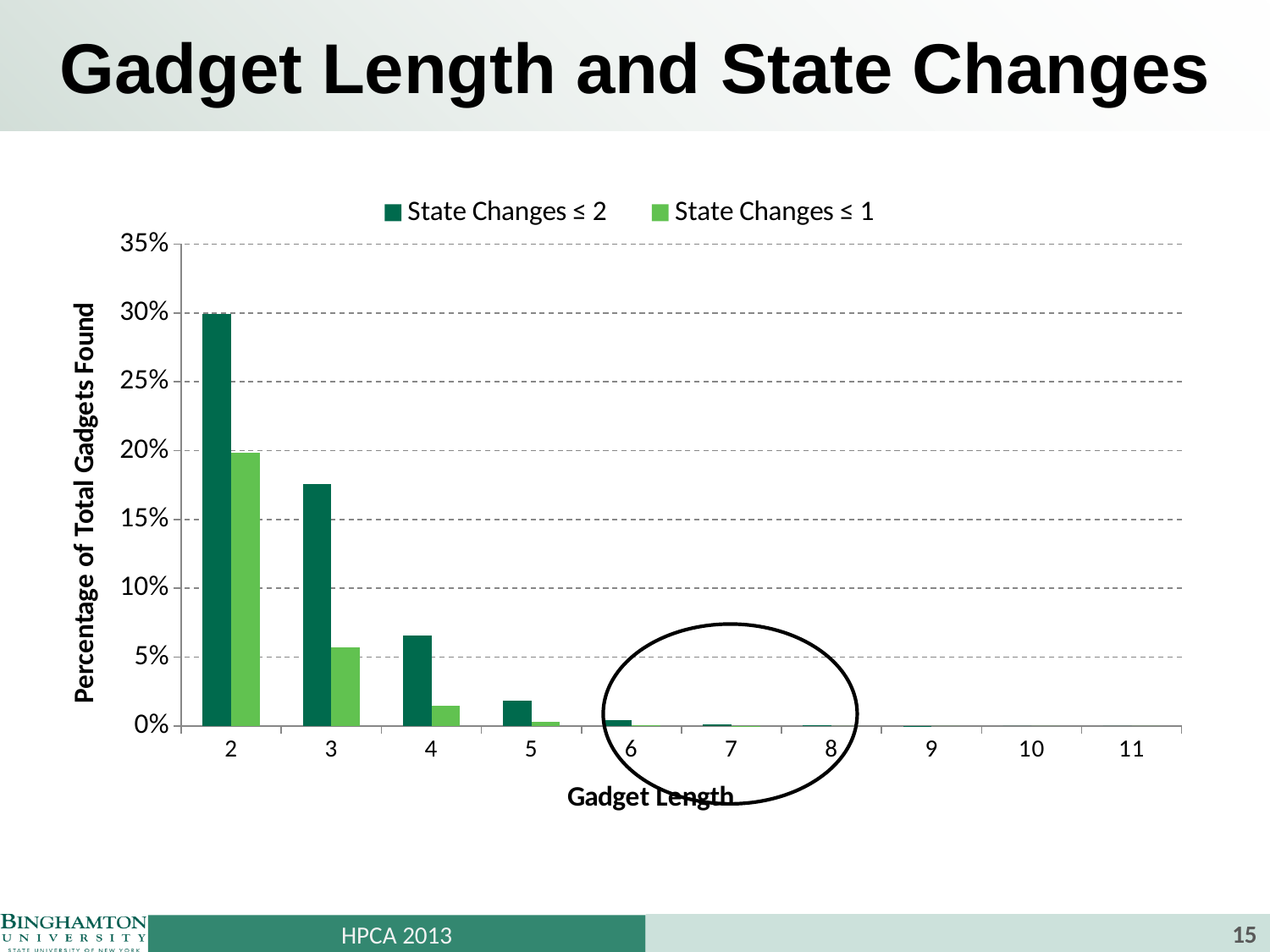
Do the values for State Changes ≤ 2 rise or fall as gadget length increases? fall At gadget length 3, which series has the larger value, State Changes ≤ 2 or State Changes ≤ 1? State Changes ≤ 2 Is the value for State Changes ≤ 1 at gadget length 3 greater or less than 10%? less Is the value for State Changes ≤ 2 at gadget length 5 greater or less than 5%? less What kind of chart is shown on the slide? bar chart How many gadget length categories are shown on the x axis? 10 Is the value for State Changes ≤ 1 at gadget length 2 greater or less than 15%? greater How many series does the legend list? 2 Which gadget length has the highest value for State Changes ≤ 1? 2 Which gadget length has the highest value for State Changes ≤ 2? 2 What is the title of the y axis? Percentage of Total Gadgets Found